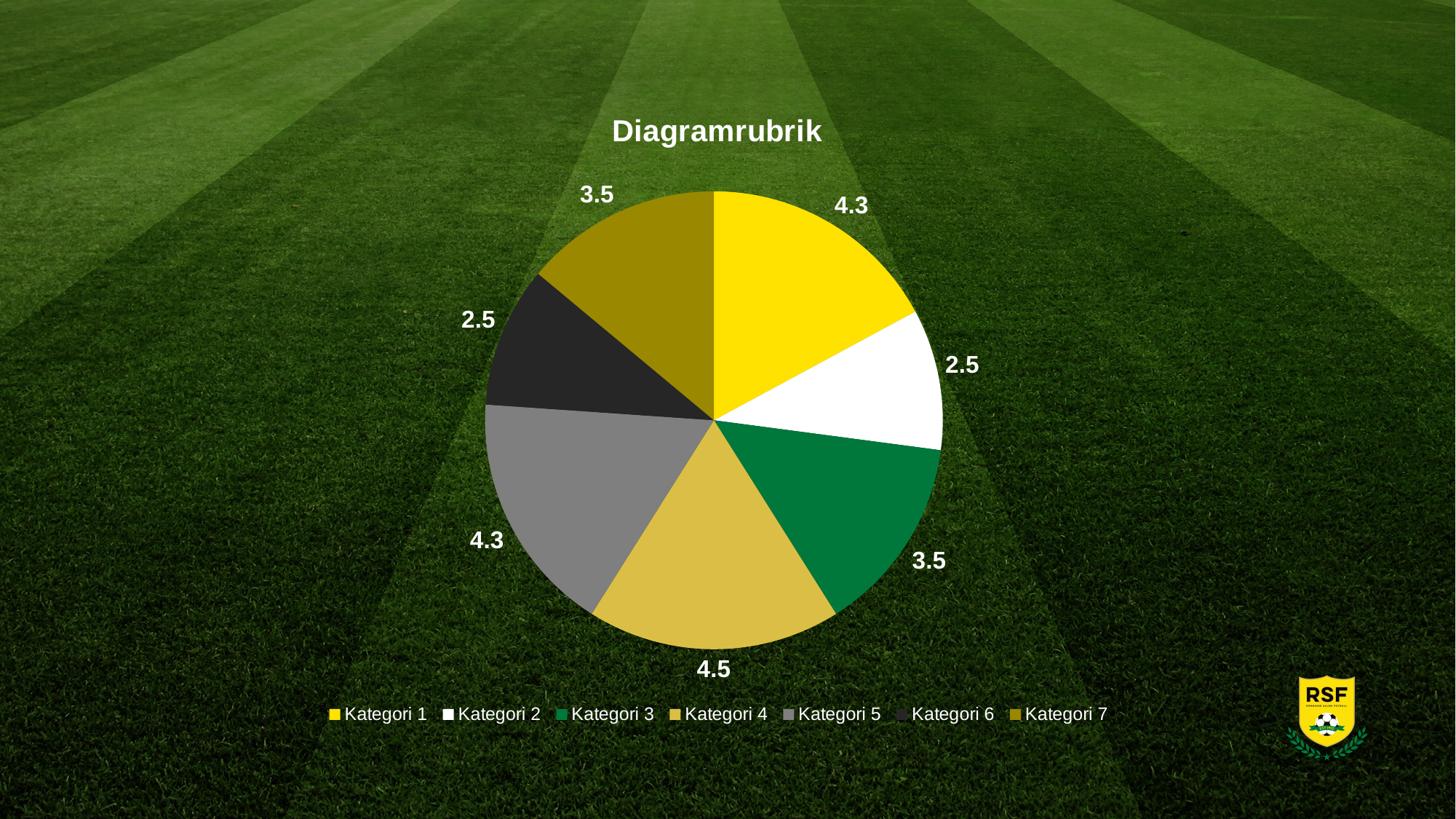
What is the value for Kategori 6? 2.5 Which category has the largest slice? Kategori 4 What is the value for Kategori 3? 3.5 What colour is the slice for Kategori 2? White What kind of chart is shown on the slide? Pie chart What is the value for Kategori 4? 4.5 What is the difference between the values for Kategori 4 and Kategori 2? 2 Which is larger, the value for Kategori 5 or the value for Kategori 6? Kategori 5 How many categories does the pie chart have? 7 What is the difference between the values for Kategori 1 and Kategori 7? 0.8 What is the title of the chart? Diagramrubrik What is the value for Kategori 1? 4.3